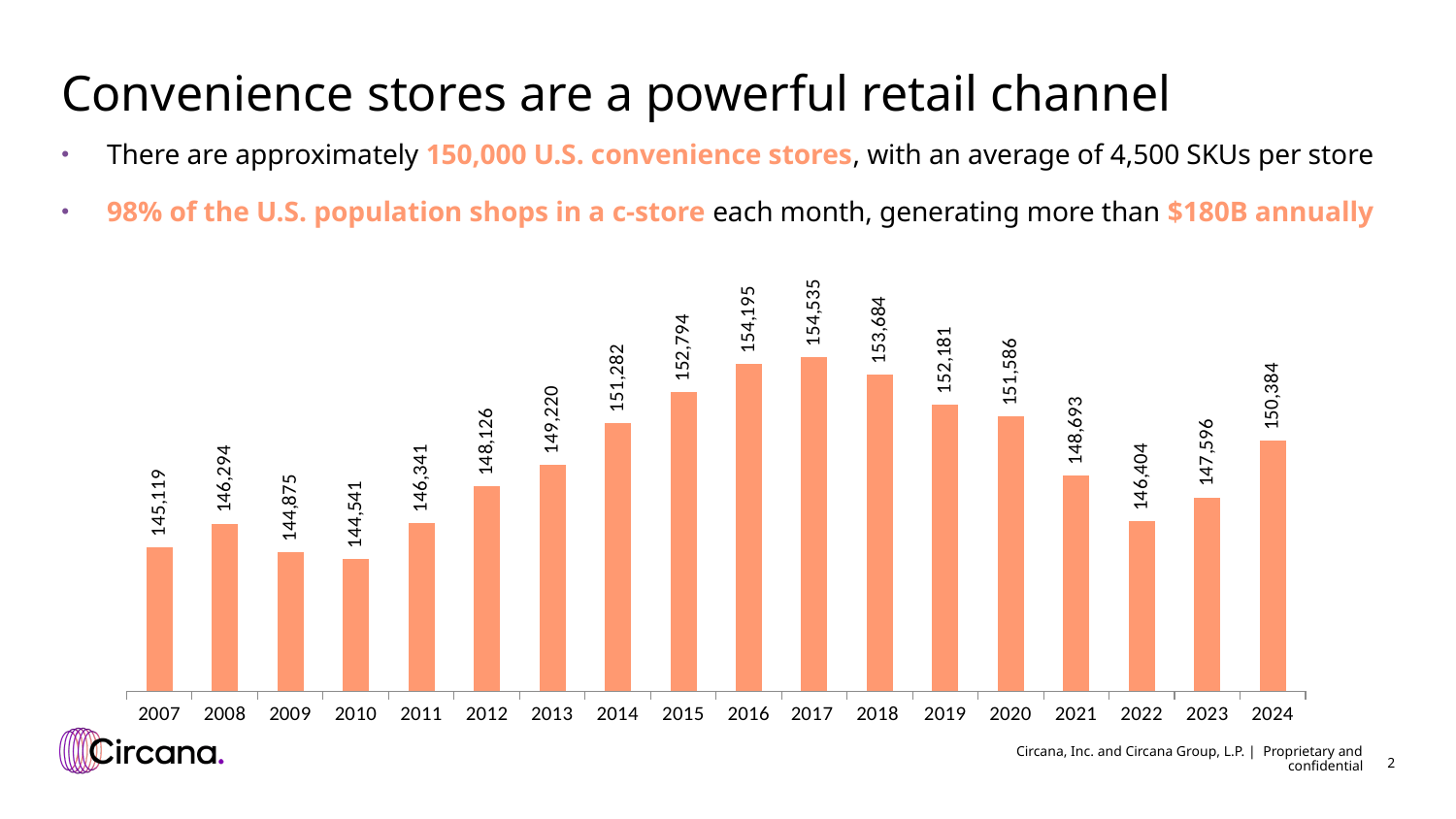
Which is larger, the value for 2014 or the value for 2021? 2014 Which year has the highest value? 2017 How many years are shown on the x axis? 18 Do the values rise or fall from 2010 to 2017? Rise What is the value shown for 2010? 144,541 What is the difference between the values for 2024 and 2023? 2,788 Do the values rise or fall from 2017 to 2022? Fall Which year has the lowest value? 2010 What is the value shown for 2024? 150,384 What is the value shown for 2017? 154,535 What is the difference between the values for 2017 and 2010? 9,994 What kind of chart is shown on the slide? Bar chart